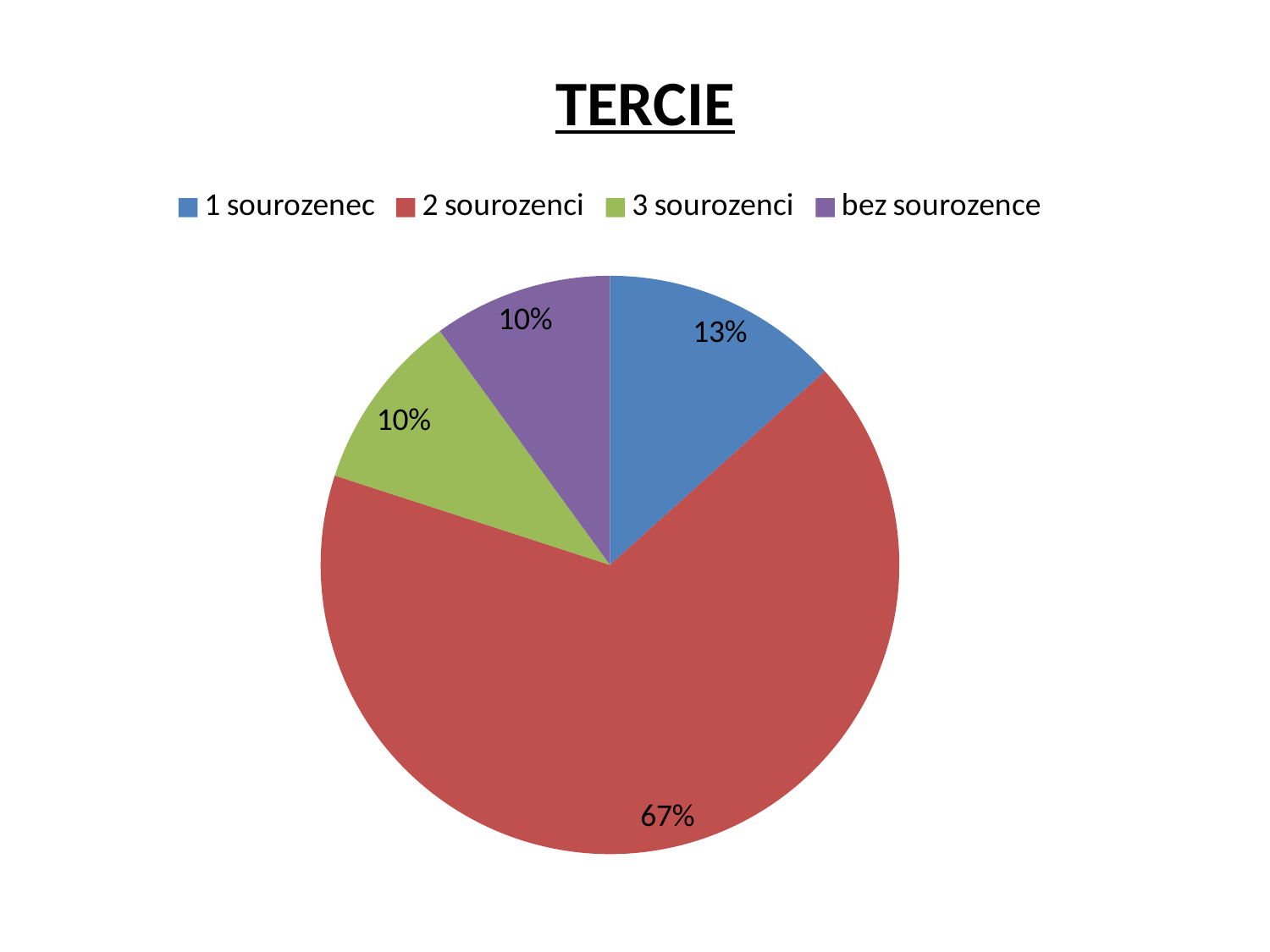
What is the difference between the shares of '2 sourozenci' and '1 sourozenec'? 54% Which category has the largest slice? 2 sourozenci How many entries does the legend list? 4 What kind of chart is shown on the slide? pie chart What share of the pie is '3 sourozenci'? 10% How many slices does the pie chart have? 4 What share of the pie is '2 sourozenci'? 67% What colour is the slice for '2 sourozenci'? red Which is larger, '1 sourozenec' or '3 sourozenci'? 1 sourozenec What share of the pie is '1 sourozenec'? 13% What is the title of the chart? TERCIE